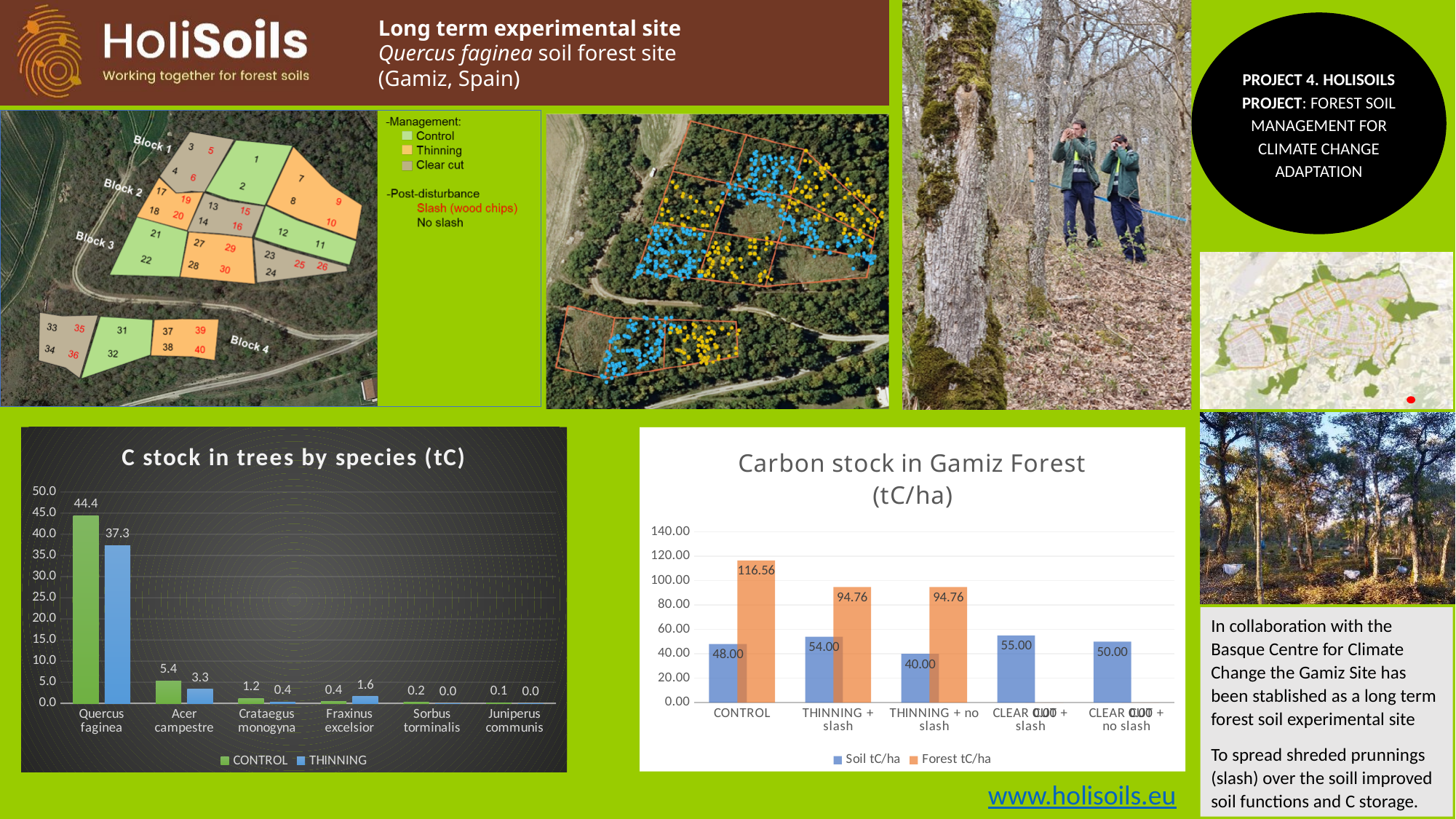
In the 'C stock in trees by species (tC)' chart, how many series does the legend list? 2 In the 'Carbon stock in Gamiz Forest (tC/ha)' chart, what is the Soil tC/ha value for THINNING + no slash? 40.00 In the 'C stock in trees by species (tC)' chart, how many species are shown on the x axis? 6 In the 'C stock in trees by species (tC)' chart, what is the THINNING value for Acer campestre? 3.3 In the 'Carbon stock in Gamiz Forest (tC/ha)' chart, what is the Forest tC/ha value for CONTROL? 116.56 In the 'C stock in trees by species (tC)' chart, is the CONTROL value for Fraxinus excelsior larger or smaller than the THINNING value? smaller What kind of chart is 'Carbon stock in Gamiz Forest (tC/ha)'? bar chart In the 'Carbon stock in Gamiz Forest (tC/ha)' chart, which treatment has the highest Soil tC/ha value? CLEAR CUT + slash In the 'Carbon stock in Gamiz Forest (tC/ha)' chart, what is the difference between the Forest tC/ha values for CONTROL and THINNING + slash? 21.80 In the 'C stock in trees by species (tC)' chart, what is the difference between the CONTROL and THINNING values for Quercus faginea? 7.1 In the 'C stock in trees by species (tC)' chart, what is the CONTROL value for Quercus faginea? 44.4 In the 'C stock in trees by species (tC)' chart, which species has the highest CONTROL value? Quercus faginea